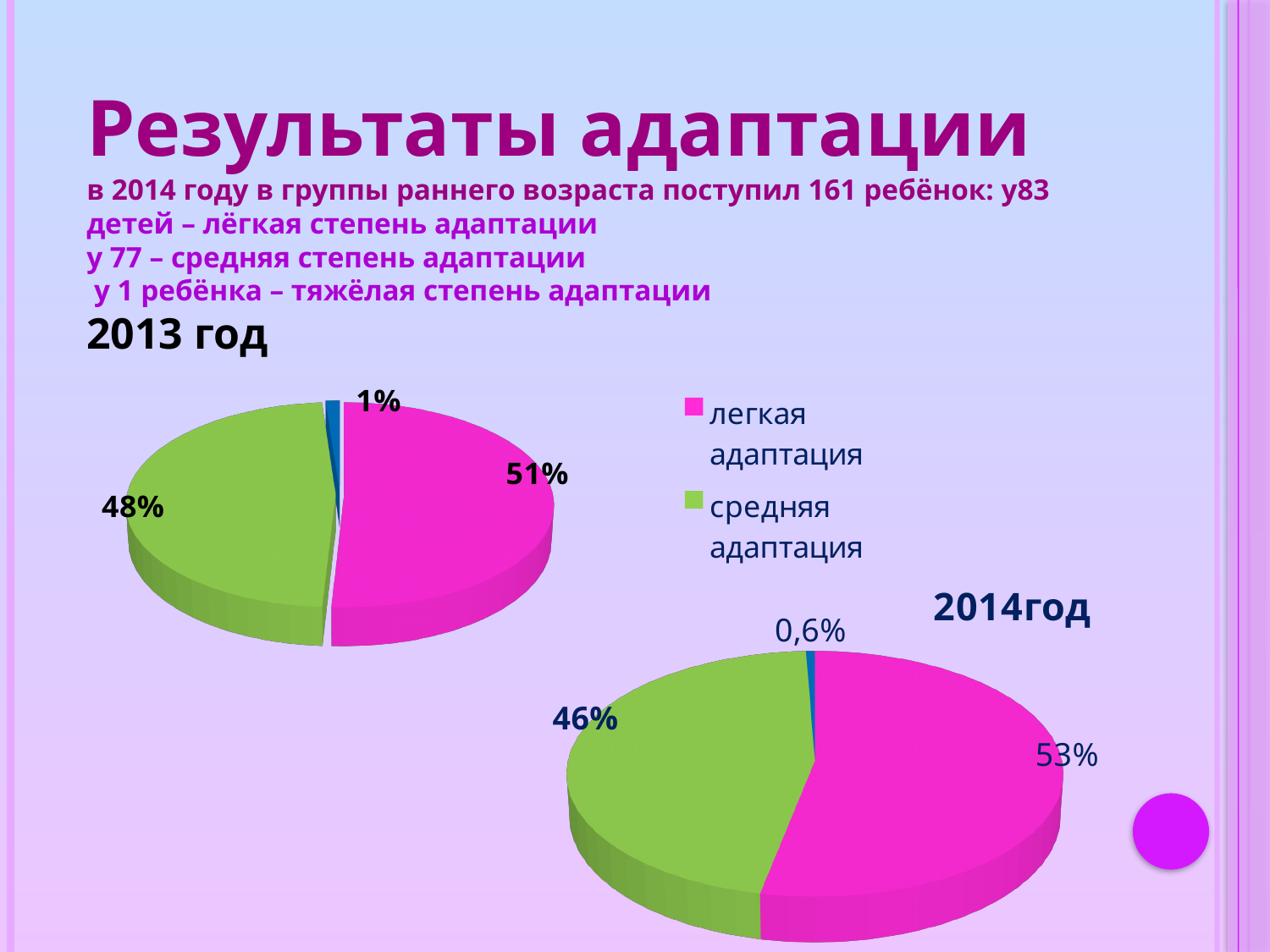
How many entries does the legend on the slide list? 2 In the 2013 год pie chart, what share is shown for средняя адаптация? 48% In the 2014год pie chart, what share is shown for средняя адаптация? 46% In the 2014год pie chart, which category has the largest slice? лёгкая адаптация In the 2014год pie chart, what value is labelled on the smallest (blue) slice? 0,6% What type of chart is used on this slide? Pie chart In the 2014год pie chart, what is the difference between the лёгкая адаптация and средняя адаптация shares? 7% In the 2013 год pie chart, what is the difference between the лёгкая адаптация and средняя адаптация shares? 3% In the 2014год pie chart, what share is shown for лёгкая адаптация? 53% In the 2013 год pie chart, which category has the largest slice? лёгкая адаптация In the 2013 год pie chart, what share is shown for лёгкая адаптация? 51% In the 2013 год pie chart, what value is labelled on the smallest (blue) slice? 1%